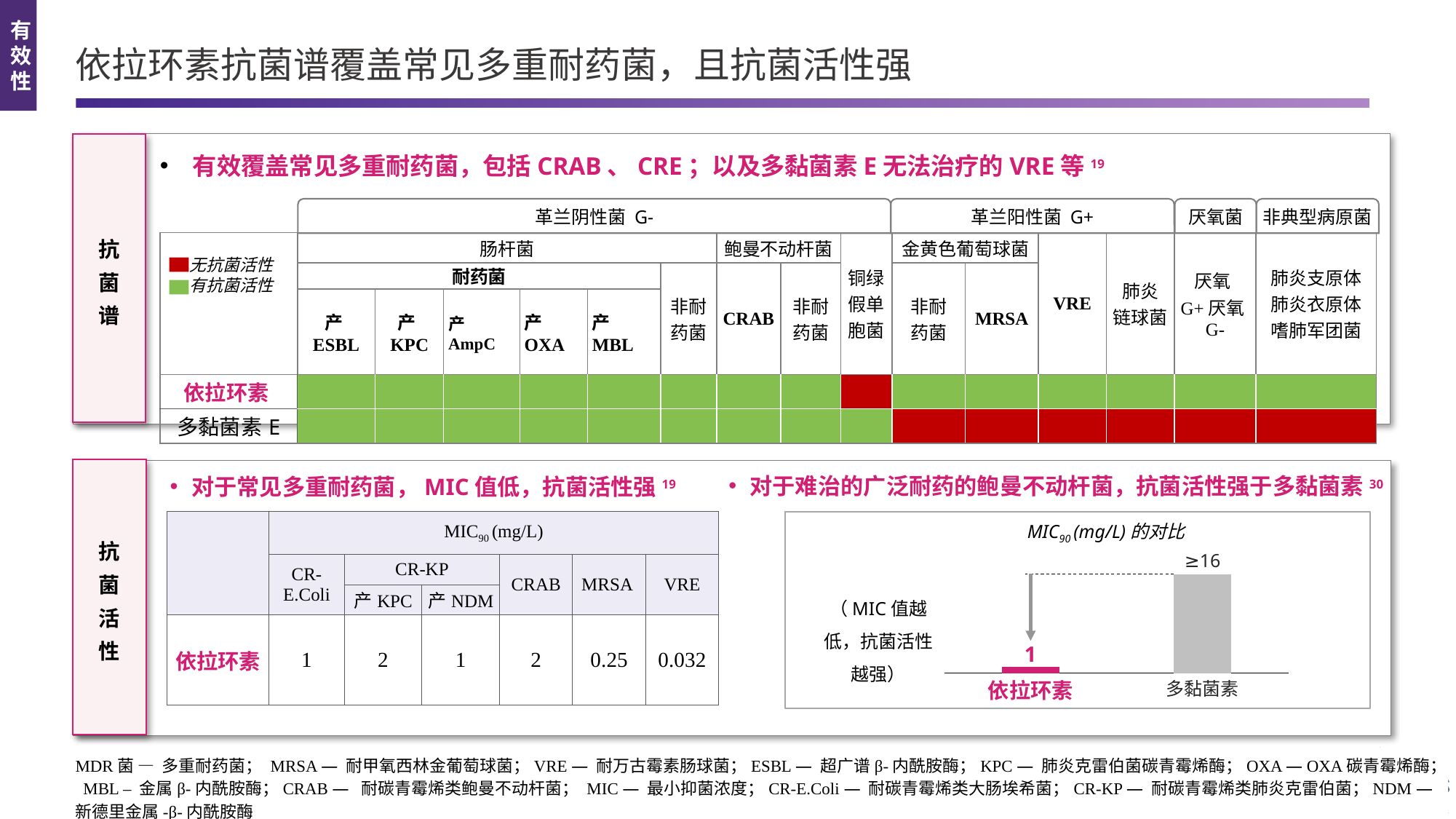
In the MIC90 (mg/L) 的对比 chart, what is the value shown for 多黏菌素? ≥16 In the MIC90 (mg/L) 的对比 chart, what colour is the bar for 依拉环素? pink What kind of chart is the MIC90 (mg/L) 的对比 chart? bar chart How many bars are plotted in the MIC90 (mg/L) 的对比 chart? 2 In the MIC90 (mg/L) 的对比 chart, which drug has the highest bar? 多黏菌素 In the MIC90 (mg/L) 的对比 chart, which drug has the lowest bar? 依拉环素 What is the title of the bar chart on the lower right of the slide? MIC90 (mg/L) 的对比 In the MIC90 (mg/L) 的对比 chart, what is the value shown for 依拉环素? 1 In the MIC90 (mg/L) 的对比 chart, which is larger, the value for 依拉环素 or the value for 多黏菌素? 多黏菌素